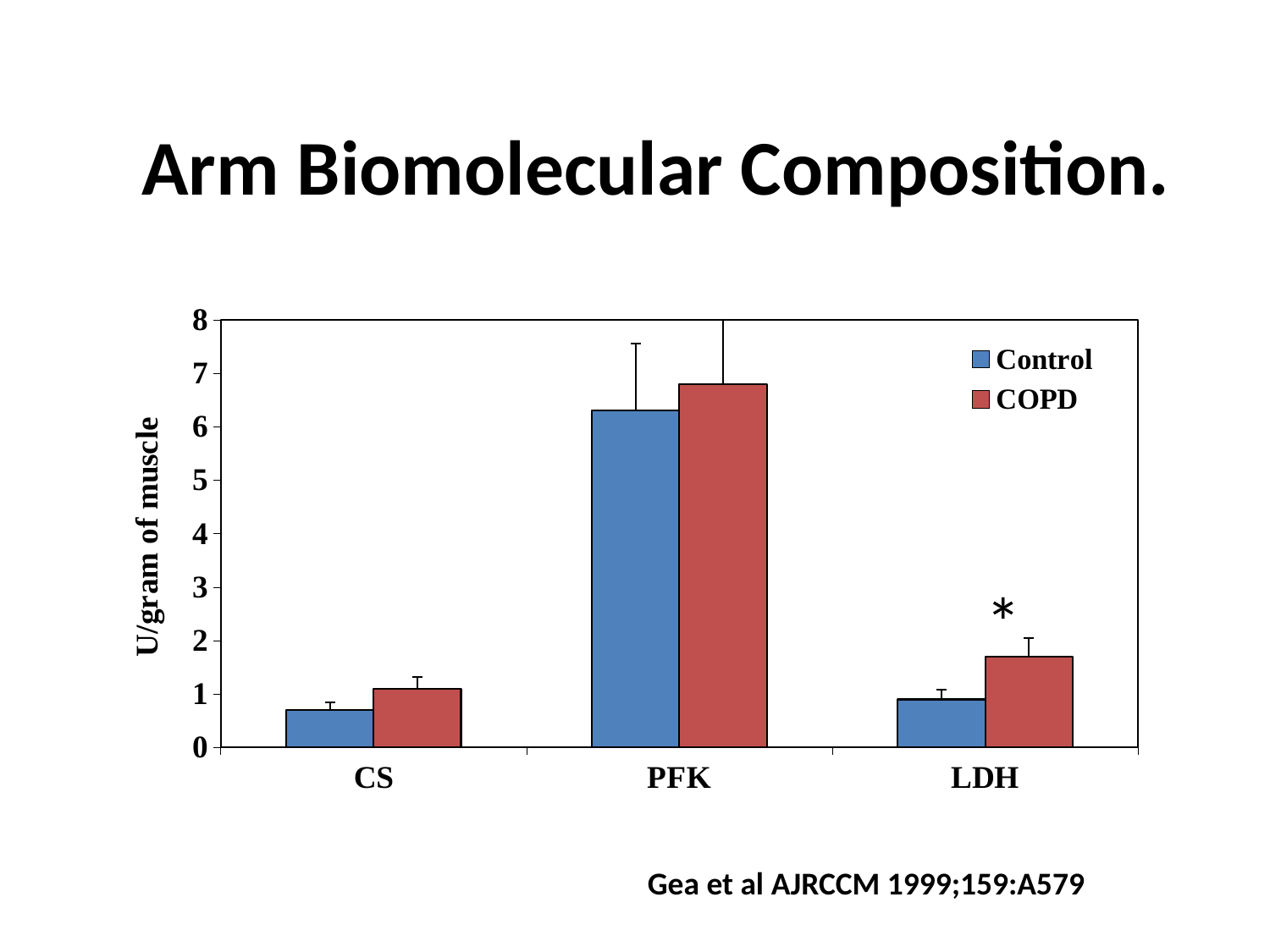
Which category has the lowest COPD value? CS Is the Control value for PFK greater or less than 6? greater What kind of chart is shown on the slide? bar chart How many series does the legend list? 2 For PFK, which is larger: the Control value or the COPD value? COPD Is the COPD value for LDH greater or less than 1? greater For LDH, which is larger: the Control value or the COPD value? COPD How many categories are shown on the x axis? 3 Is the COPD value for PFK greater or less than 7? less Which category has the highest Control value? PFK Which category is marked with an asterisk? LDH What is the label on the y axis? U/gram of muscle